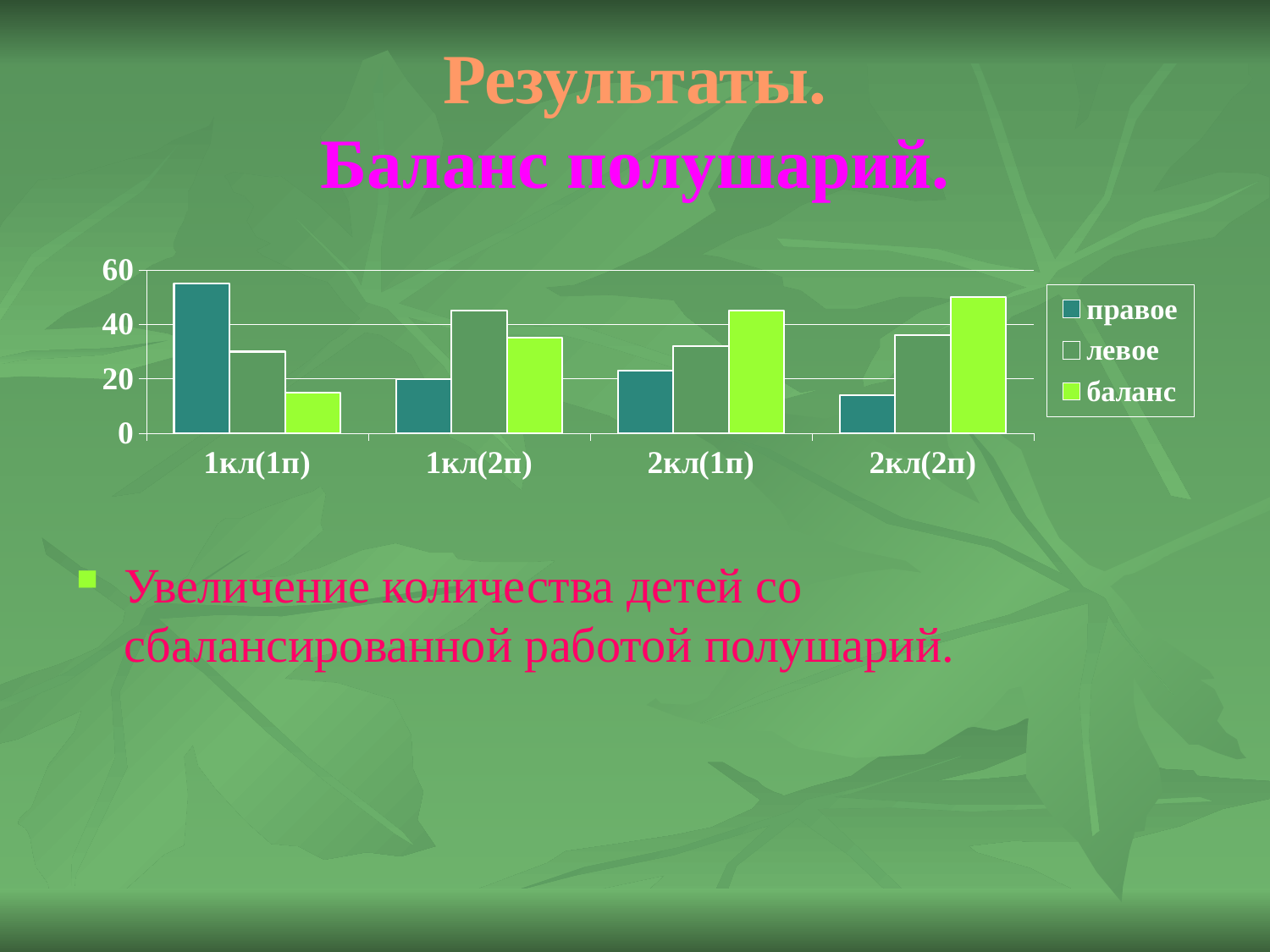
Is the value of левое for 1кл(2п) greater or less than 40? greater Is the value of правое for 2кл(2п) greater or less than 20? less How many categories are shown on the x axis of the chart? 4 For which category is the баланс series highest? 2кл(2п) Which series are listed in the chart legend? правое, левое, баланс Does the баланс series rise or fall from 1кл(1п) to 2кл(2п)? rise Is the value of баланс for 2кл(2п) greater or less than 40? greater For which category is the правое series highest? 1кл(1п) What kind of chart is shown on the slide? bar chart How many series does the chart legend list? 3